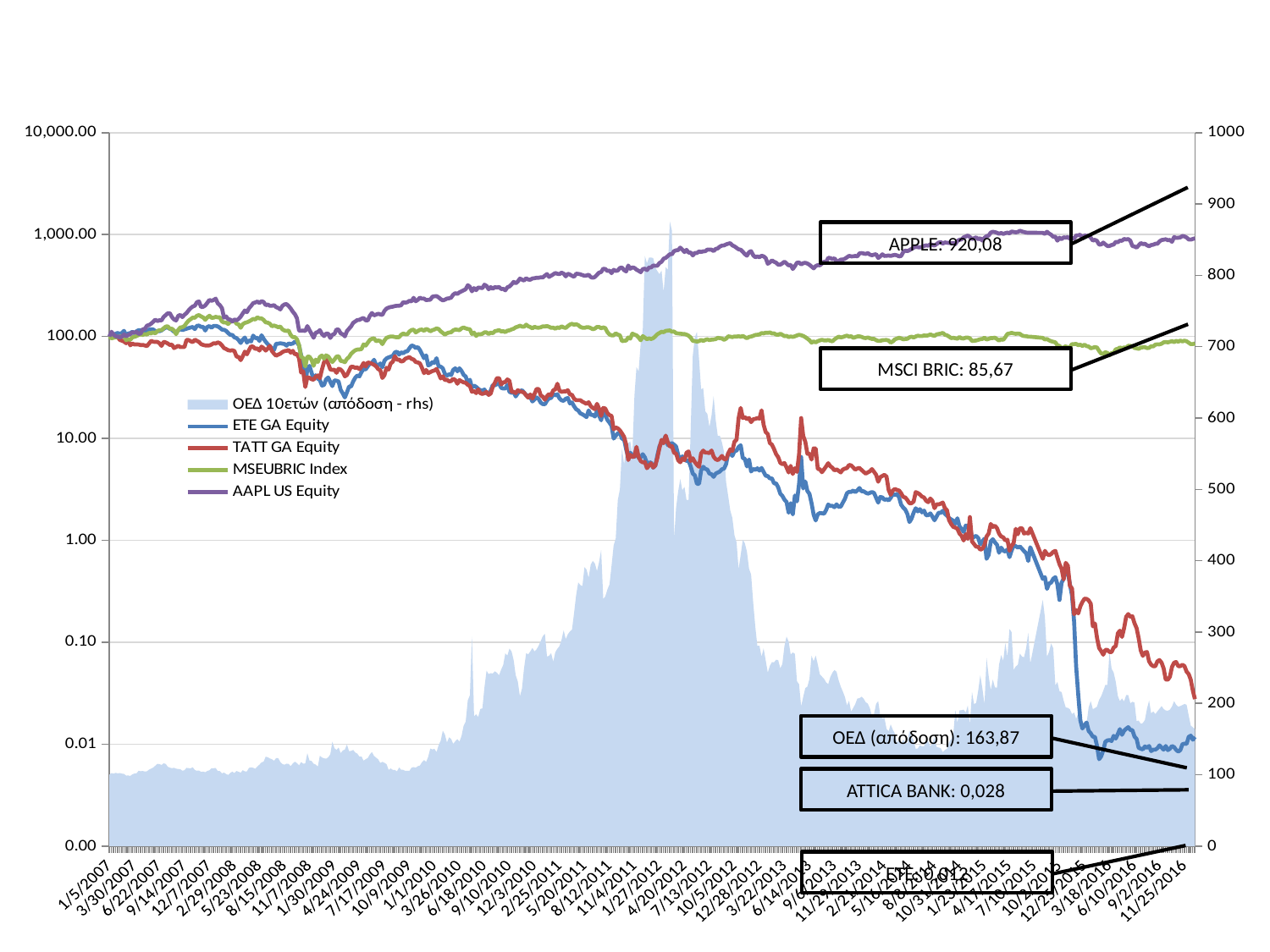
What is the difference between the labelled APPLE value and the labelled MSCI BRIC value? 834,41 What kind of chart is shown on the slide? line chart Does the ETE GA Equity line rise or fall overall from 2007 to 2016? fall What colour is the AAPL US Equity line? purple Which series is plotted on the right-hand axis according to the legend? ΟΕΔ 10ετών (απόδοση - rhs) How many series does the legend list? 5 What final value is labelled for MSCI BRIC? 85,67 At the end of the period, which is higher: the AAPL US Equity line or the MSEUBRIC Index line? AAPL US Equity Is the value of the AAPL US Equity line at the end of 2016 greater or less than 100.00 on the left axis? greater What final value is labelled for ΟΕΔ (απόδοση)? 163,87 What final value is labelled for APPLE? 920,08 What final value is labelled for ATTICA BANK? 0,028